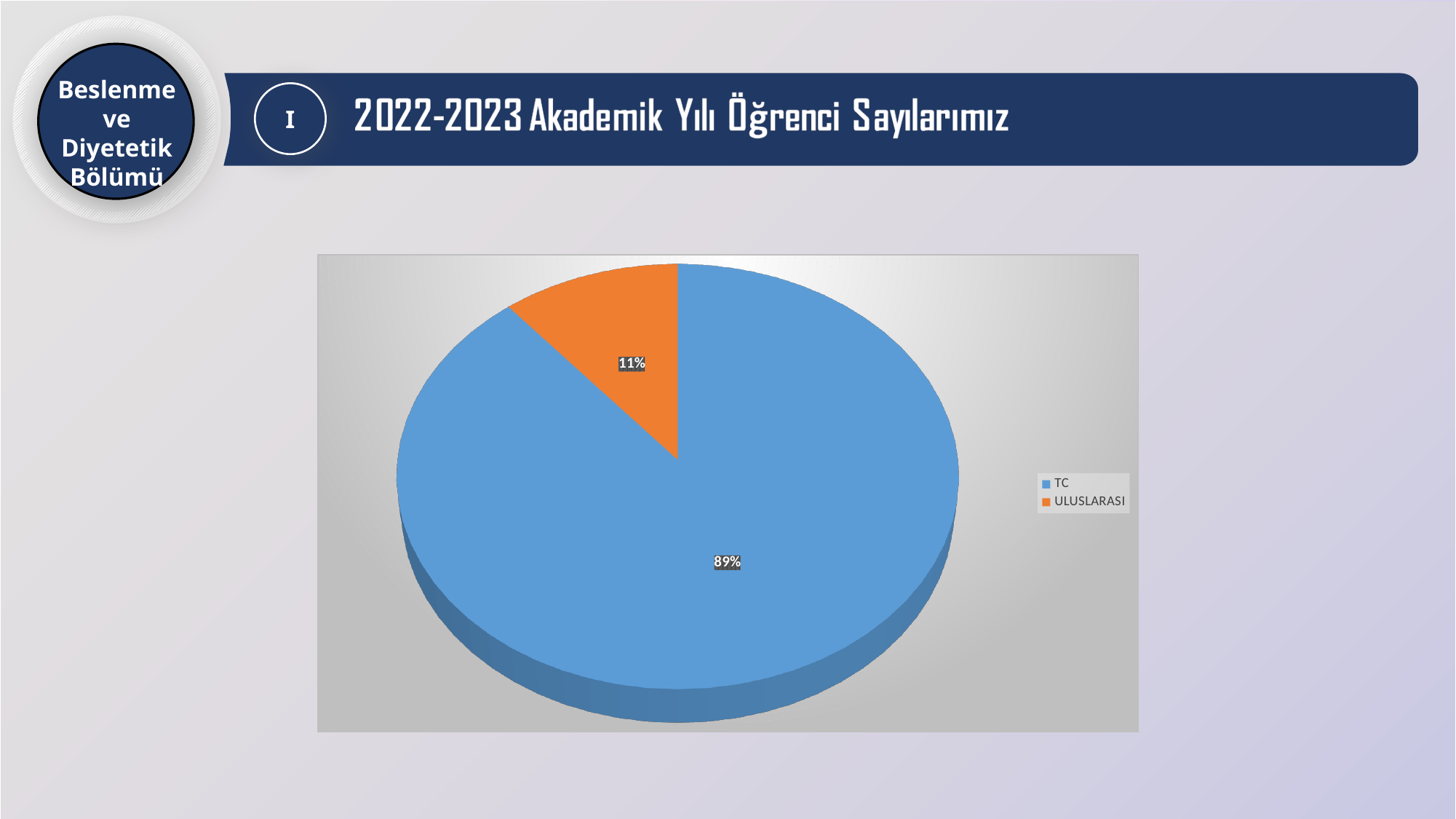
How many slices does the pie chart have? 2 What kind of chart is shown on the slide? pie chart Which category has the smallest slice of the pie? ULUSLARASI What share of the pie does the TC slice represent? 89% What colour is the TC slice? blue What is the difference in percentage points between the TC and ULUSLARASI slices? 78 What colour is the ULUSLARASI slice? orange How many entries does the legend list? 2 Which category has the largest slice of the pie? TC What share of the pie does the ULUSLARASI slice represent? 11% Which slice is larger, TC or ULUSLARASI? TC